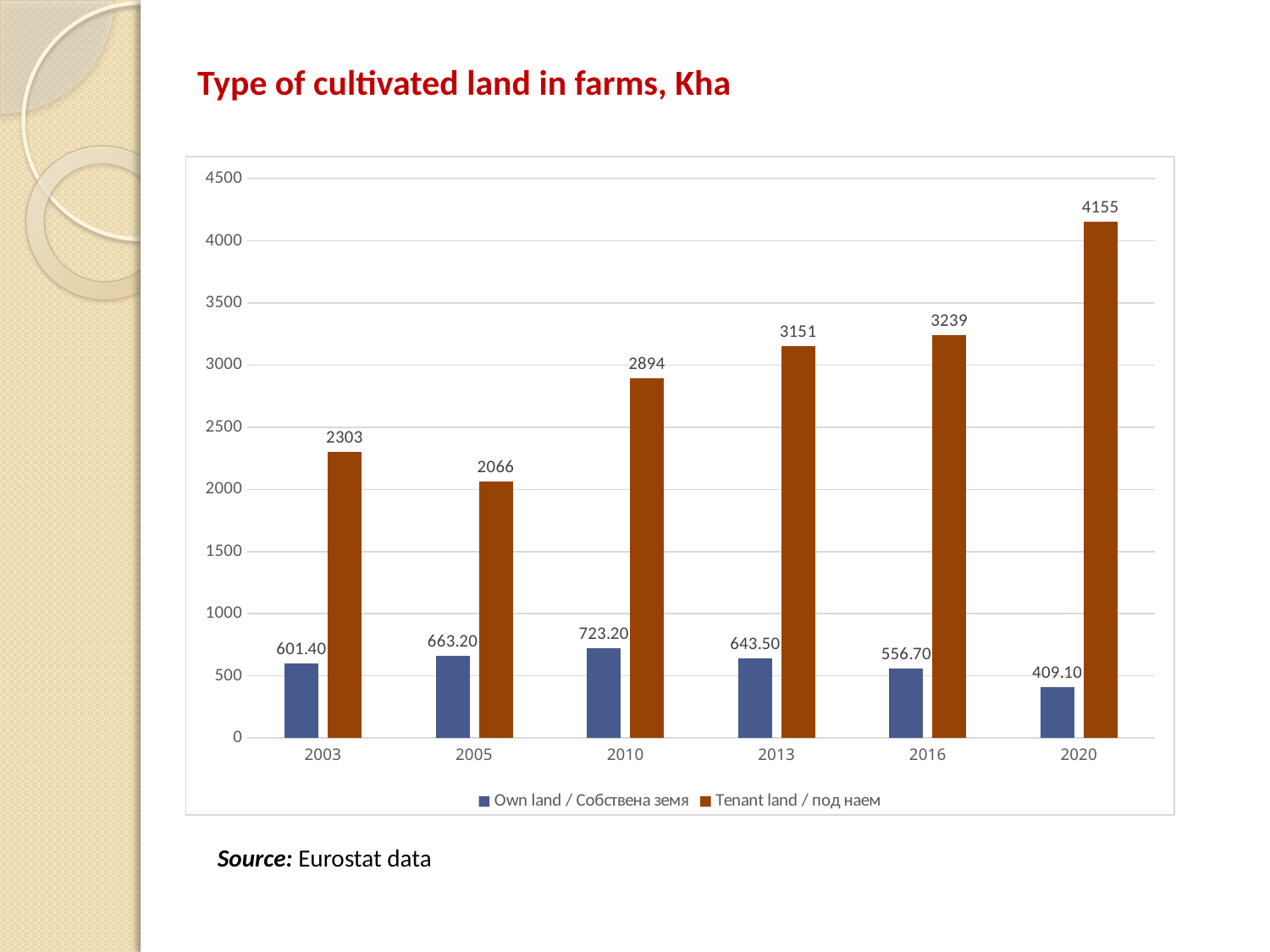
What is the value for Tenant land in 2020? 4155 In which year is the Own land value highest? 2010 What is the difference between the Tenant land values in 2020 and 2016? 916 In which year is the Own land value lowest? 2020 What is the value for Tenant land in 2005? 2066 What is the value for Own land in 2003? 601.40 Which is larger in 2013: Own land or Tenant land? Tenant land What kind of chart is shown? Bar chart How many years are shown on the x axis? 6 Does the Own land value rise or fall from 2010 to 2020? Fall How many series does the legend list? 2 In which year is the Tenant land value lowest? 2005